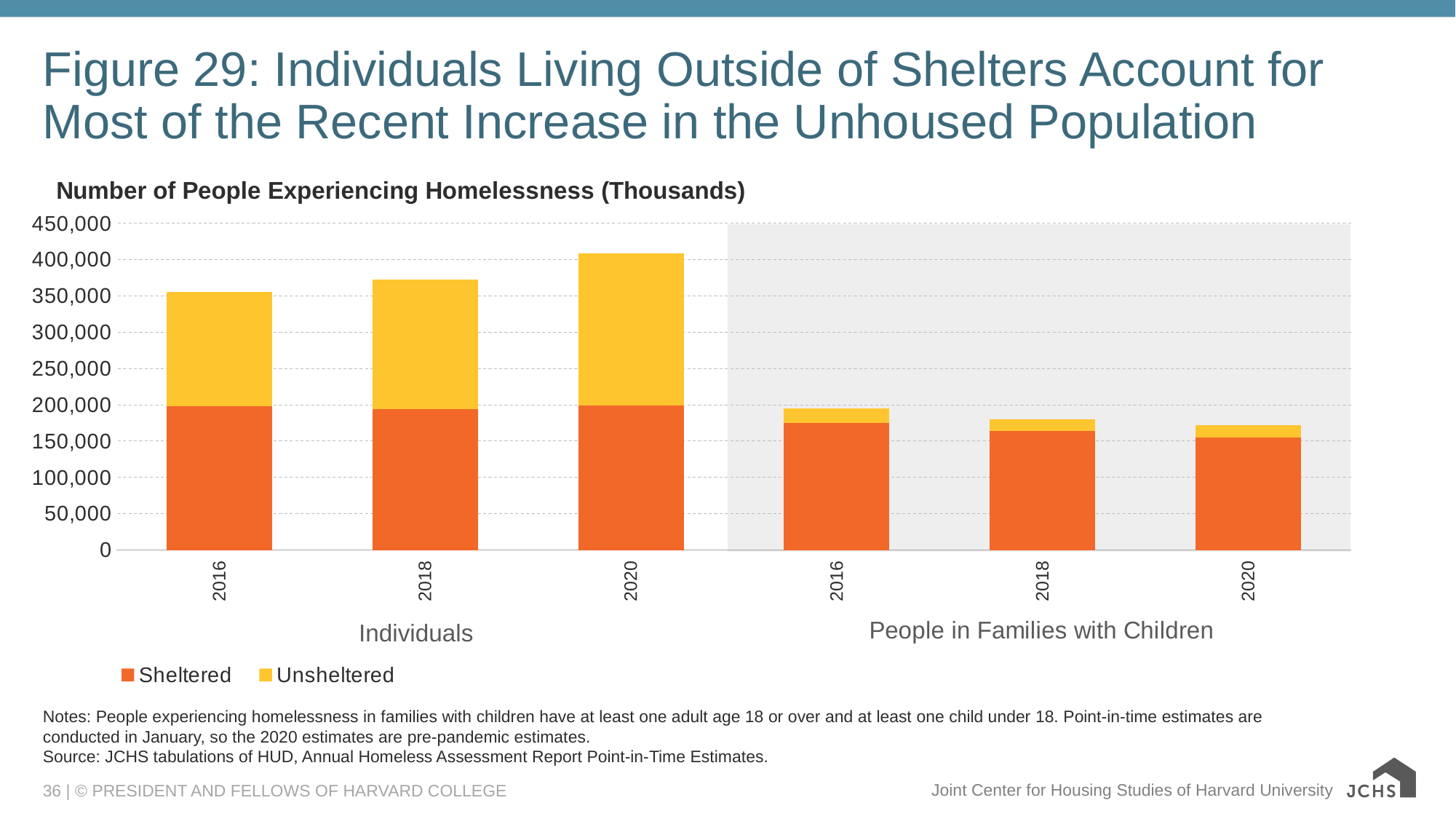
Is the total for Individuals in 2016 greater or less than 300,000? greater What kind of chart is shown on the slide? Stacked bar chart Is the total for People in Families with Children in 2020 greater or less than 200,000? less How many series does the legend list? 2 How many bars are plotted in the chart? 6 Which bar has the lowest total number of people experiencing homelessness? People in Families with Children, 2020 Do the total bars for Individuals rise or fall from 2016 to 2020? rise Which bar has the highest total number of people experiencing homelessness? Individuals, 2020 What are the two series named in the legend? Sheltered and Unsheltered Do the total bars for People in Families with Children rise or fall from 2016 to 2020? fall Is the total for Individuals in 2020 greater or less than 400,000? greater Which is larger in 2020: the total for Individuals or the total for People in Families with Children? Individuals